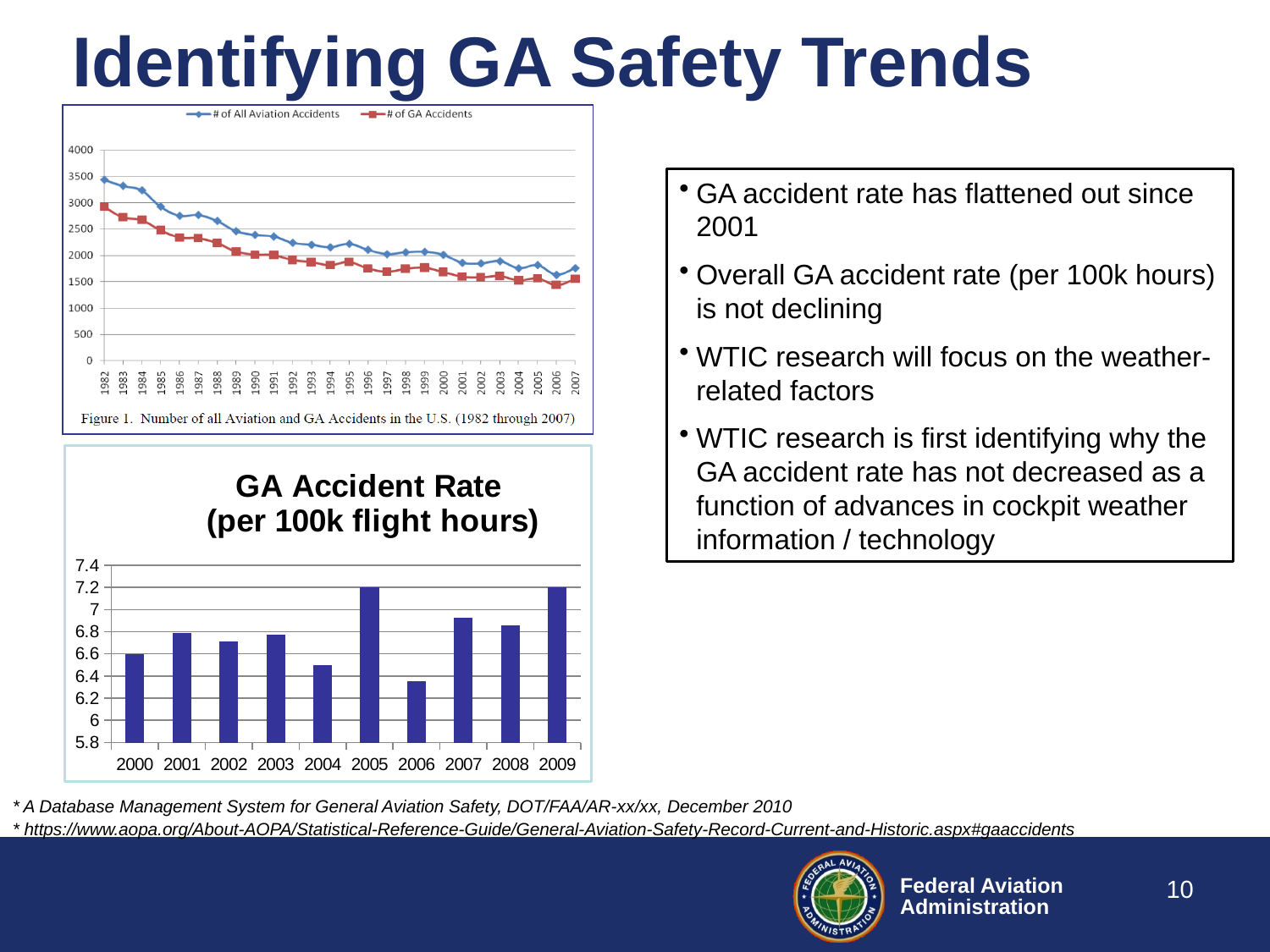
In the top chart (Figure 1), which series has the larger value in 1982, # of All Aviation Accidents or # of GA Accidents? # of All Aviation Accidents What kind of chart is the bottom chart titled "GA Accident Rate (per 100k flight hours)"? bar chart How many series does the legend of the top chart (Figure 1) list? 2 In the bottom chart "GA Accident Rate (per 100k flight hours)", which year has the lowest accident rate? 2006 In the bottom chart "GA Accident Rate (per 100k flight hours)", is the value for 2007 greater or less than 6.8? greater In the bottom chart "GA Accident Rate (per 100k flight hours)", is the value for 2004 greater or less than 6.6? less In the top chart (Figure 1), do the number of all aviation accidents rise or fall from 1982 to 2007? fall In the bottom chart "GA Accident Rate (per 100k flight hours)", which year has the larger value, 2005 or 2006? 2005 In the bottom chart "GA Accident Rate (per 100k flight hours)", is the value for 2006 greater or less than 6.4? less What kind of chart is the top chart (Figure 1, Number of all Aviation and GA Accidents)? line chart How many years are shown on the x axis of the bottom chart "GA Accident Rate (per 100k flight hours)"? 10